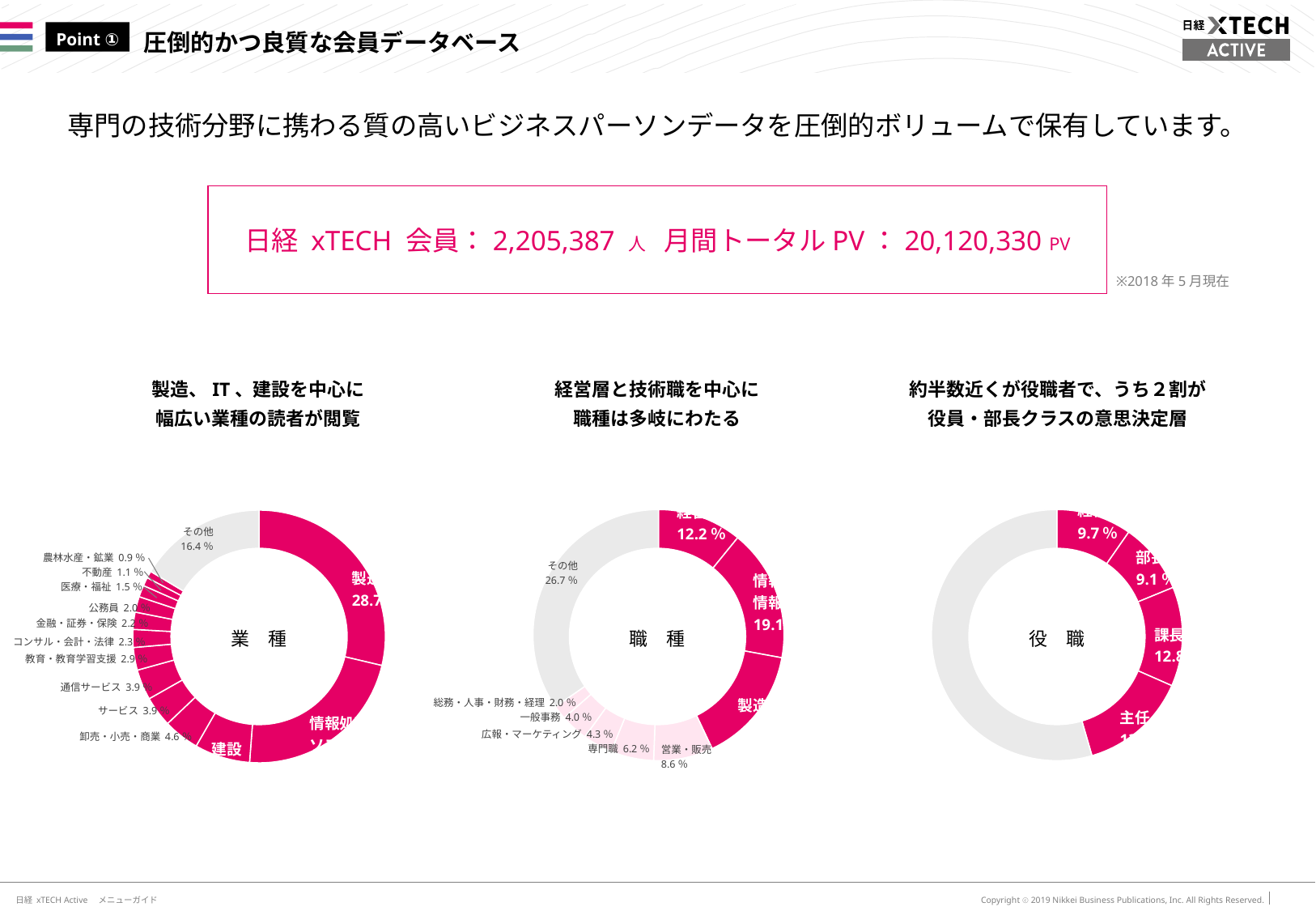
In the 職種 chart, what is the difference between 営業・販売 and 専門職? 2.4% In the 役職 chart, what is the value for 部長? 9.1% In the 職種 chart, what is the value for その他? 26.7% In the 業種 chart, what is the difference between 卸売・小売・商業 and 通信サービス? 0.7% In the 業種 chart, what is the value for 卸売・小売・商業? 4.6% In the 業種 chart, what is the value for その他? 16.4% In the 職種 chart, which labeled category has the smallest share? 総務・人事・財務・経理 What kind of chart is the 業種 chart on the left of the slide? Doughnut (ring) chart How many doughnut charts are shown on the slide? 3 In the 役職 chart, which is larger, 経営 or 部長? 経営 In the 業種 chart, which category has the smallest share? 農林水産・鉱業 In the 職種 chart, what is the value for 営業・販売? 8.6%